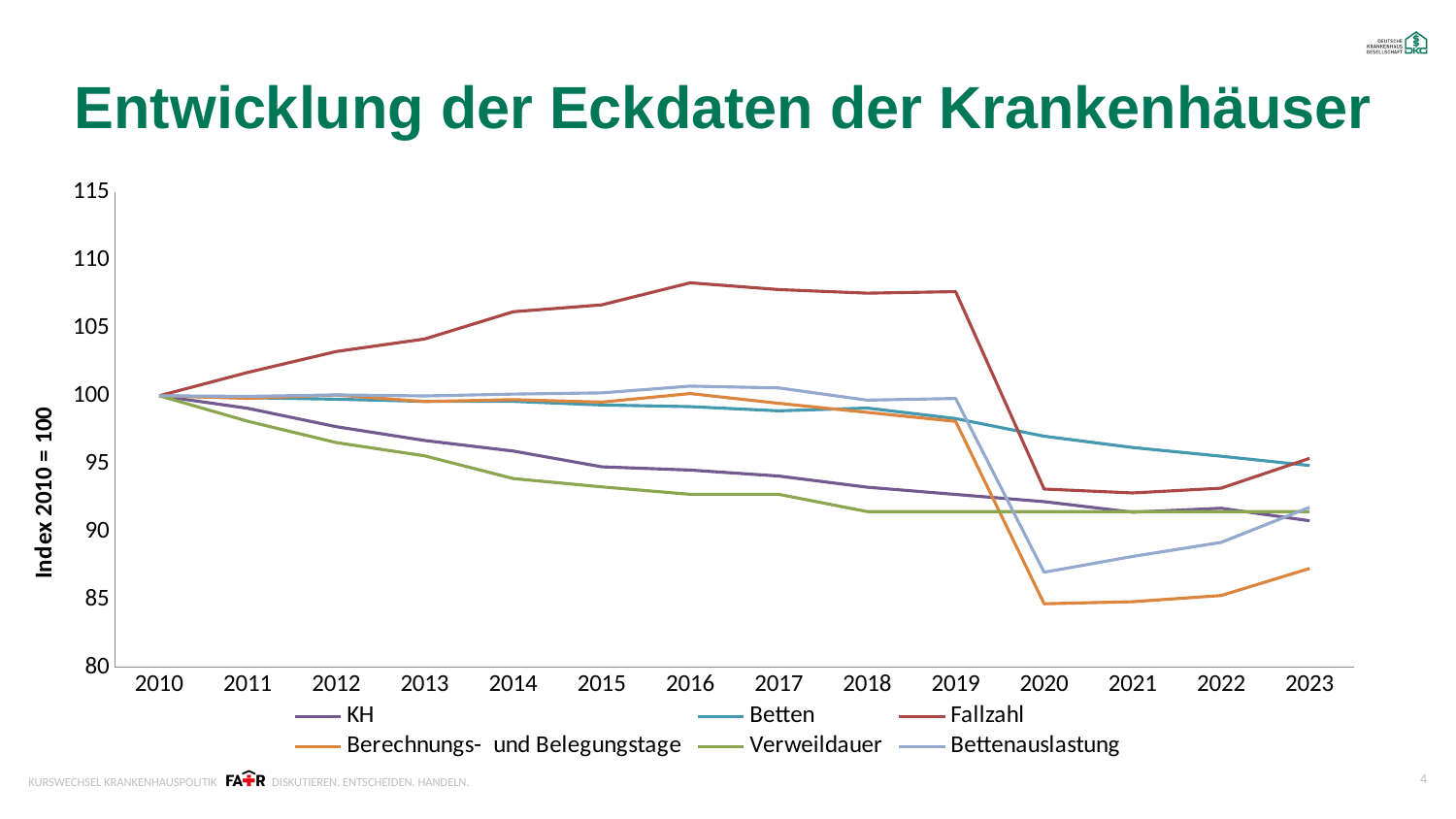
How many series does the legend list? 6 How many years are shown on the x axis? 14 Does the KH series rise or fall from 2010 to 2023? fall In 2023, which is higher: Fallzahl or KH? Fallzahl Is the value for Fallzahl in 2016 greater or less than 105? greater Is the value for Verweildauer in 2018 greater or less than 95? less What kind of chart is shown on the slide? line chart Is the value for Bettenauslastung in 2020 greater or less than 90? less Which series has the highest value in 2019? Fallzahl Which series has the lowest value in 2023? Berechnungs- und Belegungstage What is the index value of the Fallzahl series in 2010? 100